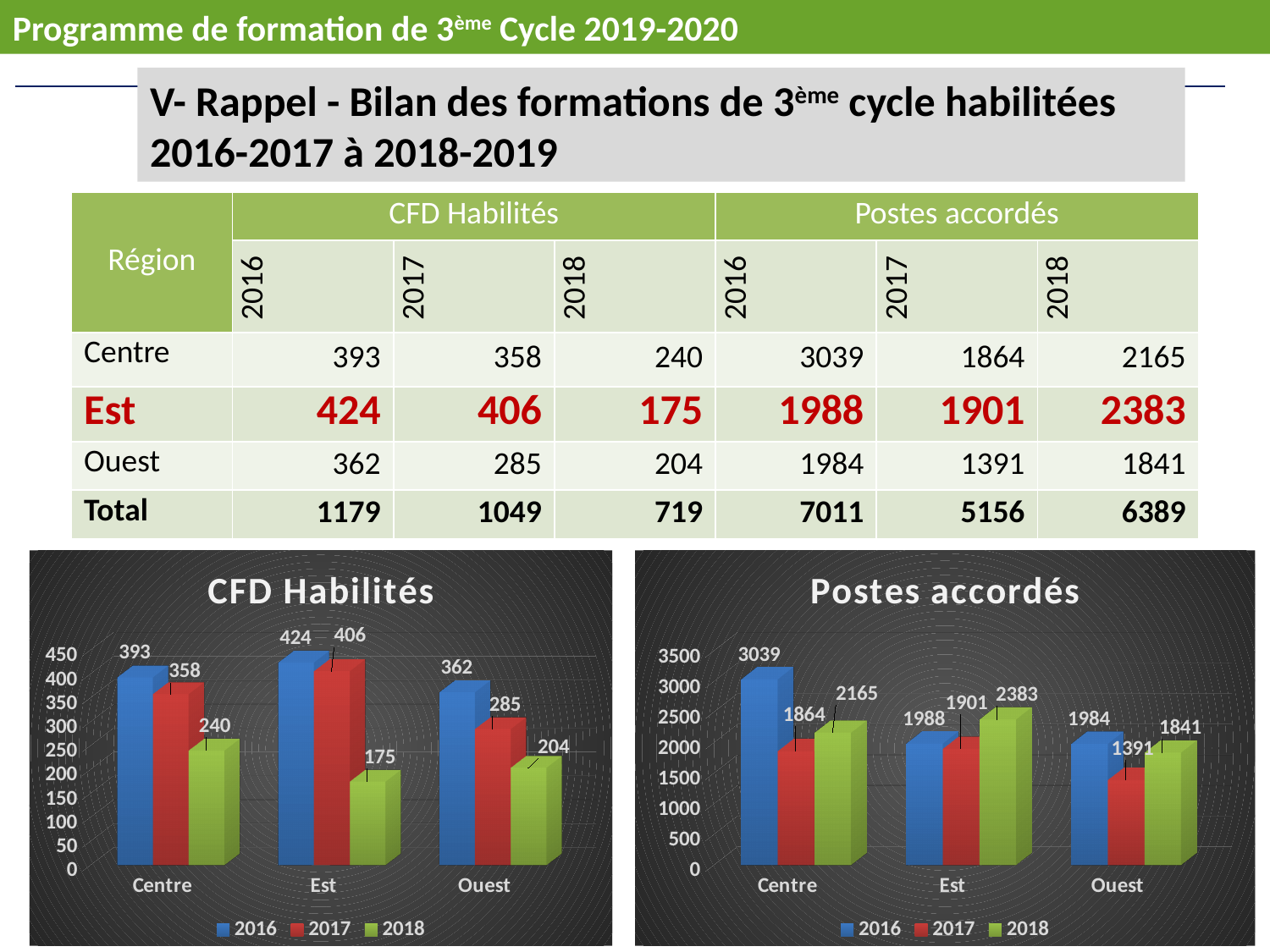
In the 'Postes accordés' chart, is the 2016 value for Centre greater or less than 3000? greater How many series does the legend of the 'Postes accordés' chart list? 3 What kind of chart is the 'CFD Habilités' chart? Bar chart In the 'Postes accordés' chart, which region has the highest value for 2016? Centre In the 'CFD Habilités' chart, do the values for Ouest rise or fall from 2016 to 2018? Fall How many regions are shown on the x axis of the 'CFD Habilités' chart? 3 In the 'CFD Habilités' chart, which is larger: the 2017 value for Centre or the 2017 value for Ouest? Centre In the 'CFD Habilités' chart, which region has the lowest value for 2018? Est In the 'CFD Habilités' chart, what is the value for Est in 2016? 424 In the 'Postes accordés' chart, what is the difference between the 2018 values for Est and Ouest? 542 In the 'CFD Habilités' chart, what is the difference between the 2016 and 2018 values for Centre? 153 In the 'Postes accordés' chart, what is the value for Ouest in 2017? 1391